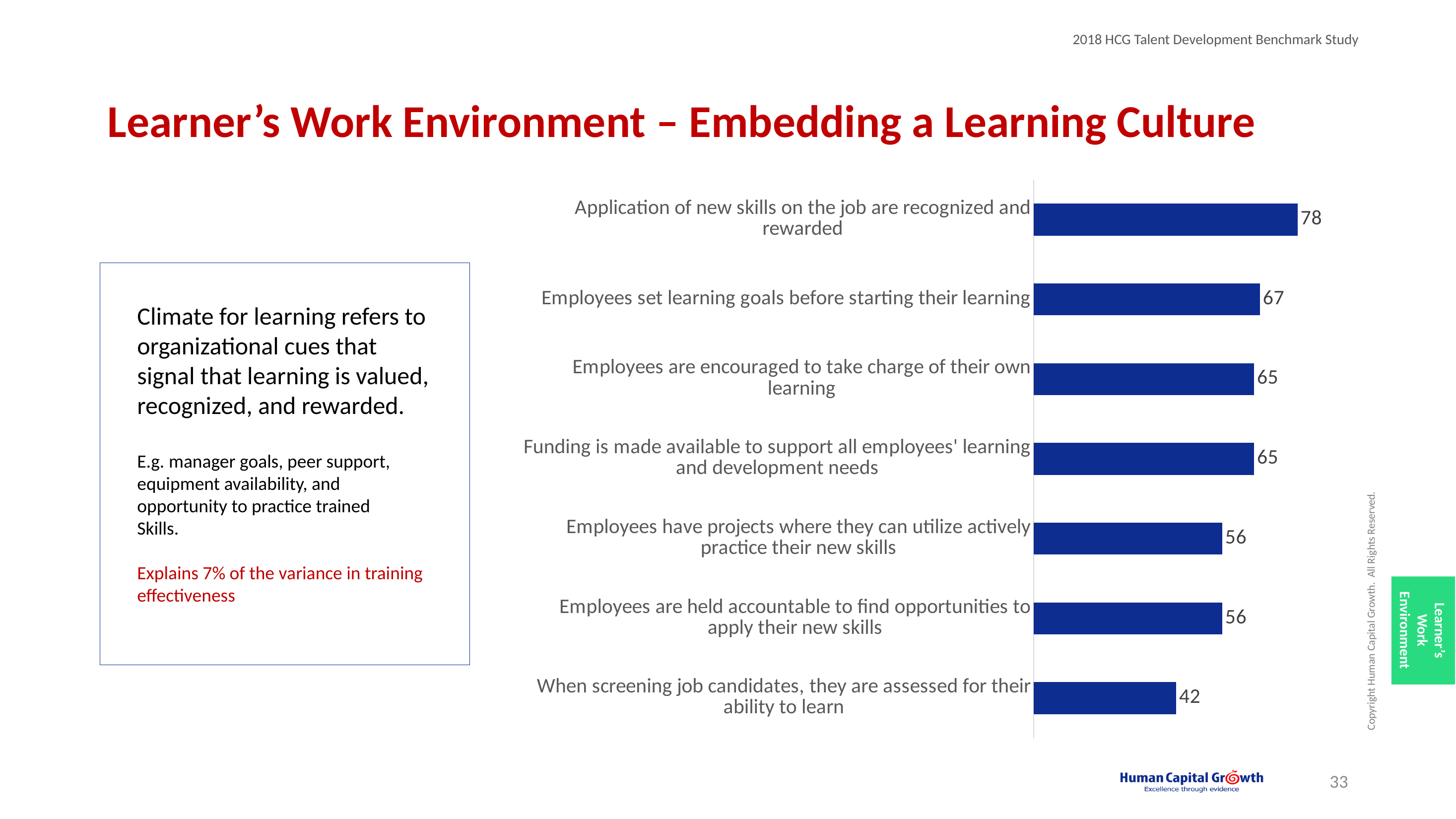
Which is larger: the value for "Employees set learning goals before starting their learning" or the value for "Employees are encouraged to take charge of their own learning"? Employees set learning goals before starting their learning What colour are the bars in the chart? Dark blue What is the value for "Employees set learning goals before starting their learning"? 67 Which category has the highest value? Application of new skills on the job are recognized and rewarded How many categories are shown in the bar chart? 7 What is the value for "Application of new skills on the job are recognized and rewarded"? 78 What is the value for "When screening job candidates, they are assessed for their ability to learn"? 42 Which category has the lowest value? When screening job candidates, they are assessed for their ability to learn What is the difference between "Employees set learning goals before starting their learning" and "Employees have projects where they can utilize actively practice their new skills"? 11 What is the difference between the highest and lowest values in the chart? 36 What is the value for "Funding is made available to support all employees' learning and development needs"? 65 What type of chart is shown on the slide? Bar chart